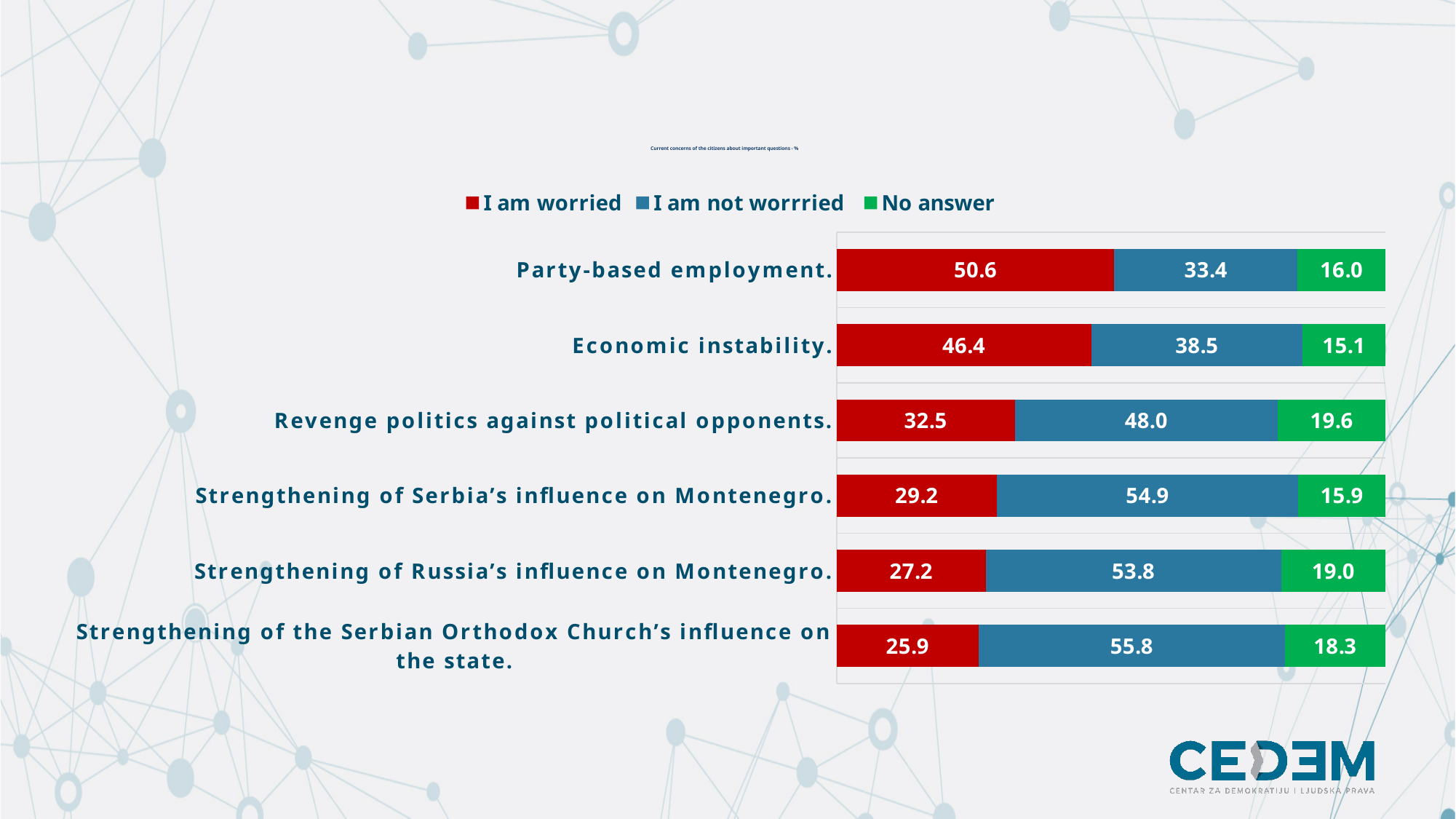
How many categories are shown in the chart? 6 What kind of chart is shown on the slide? Stacked bar chart Which colour represents the 'No answer' series in the chart? Green What is the 'No answer' value for Revenge politics against political opponents? 19.6 What percentage of respondents are worried about party-based employment? 50.6 What is the 'I am not worrried' value for Strengthening of Serbia's influence on Montenegro? 54.9 Which category has the highest 'I am worried' value? Party-based employment. Which is larger: the 'I am not worrried' value for Strengthening of Russia's influence on Montenegro or for Revenge politics against political opponents? Strengthening of Russia's influence on Montenegro How many series does the legend list? 3 What is the total of the stacked bar for Economic instability? 100.0 What is the difference between the 'I am worried' values for Party-based employment and Economic instability? 4.2 Which category has the lowest 'I am worried' value? Strengthening of the Serbian Orthodox Church's influence on the state.